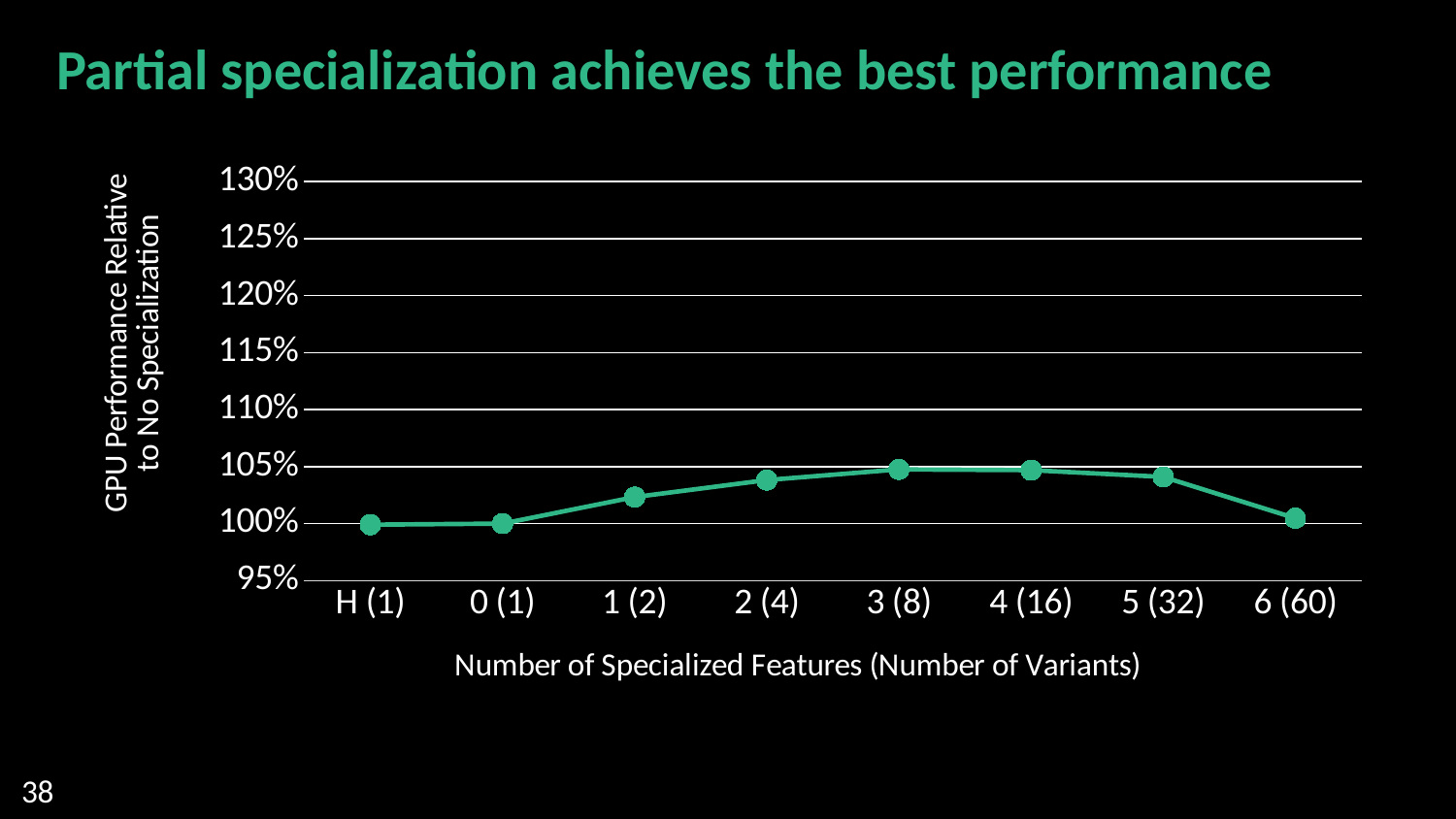
How many data points are plotted on the chart? 8 Which has the larger value, 2 (4) or 0 (1)? 2 (4) Is the value for 2 (4) greater or less than 100%? greater What is the title of the chart on the slide? Partial specialization achieves the best performance What is the label of the x axis? Number of Specialized Features (Number of Variants) Is the value for 1 (2) greater or less than 105%? less Is the value for 6 (60) greater or less than 105%? less What kind of chart is shown on the slide? line chart How does the value change from 4 (16) to 6 (60) along the x axis? it falls Which has the larger value, 3 (8) or 6 (60)? 3 (8) Which has the larger value, 5 (32) or 1 (2)? 5 (32)